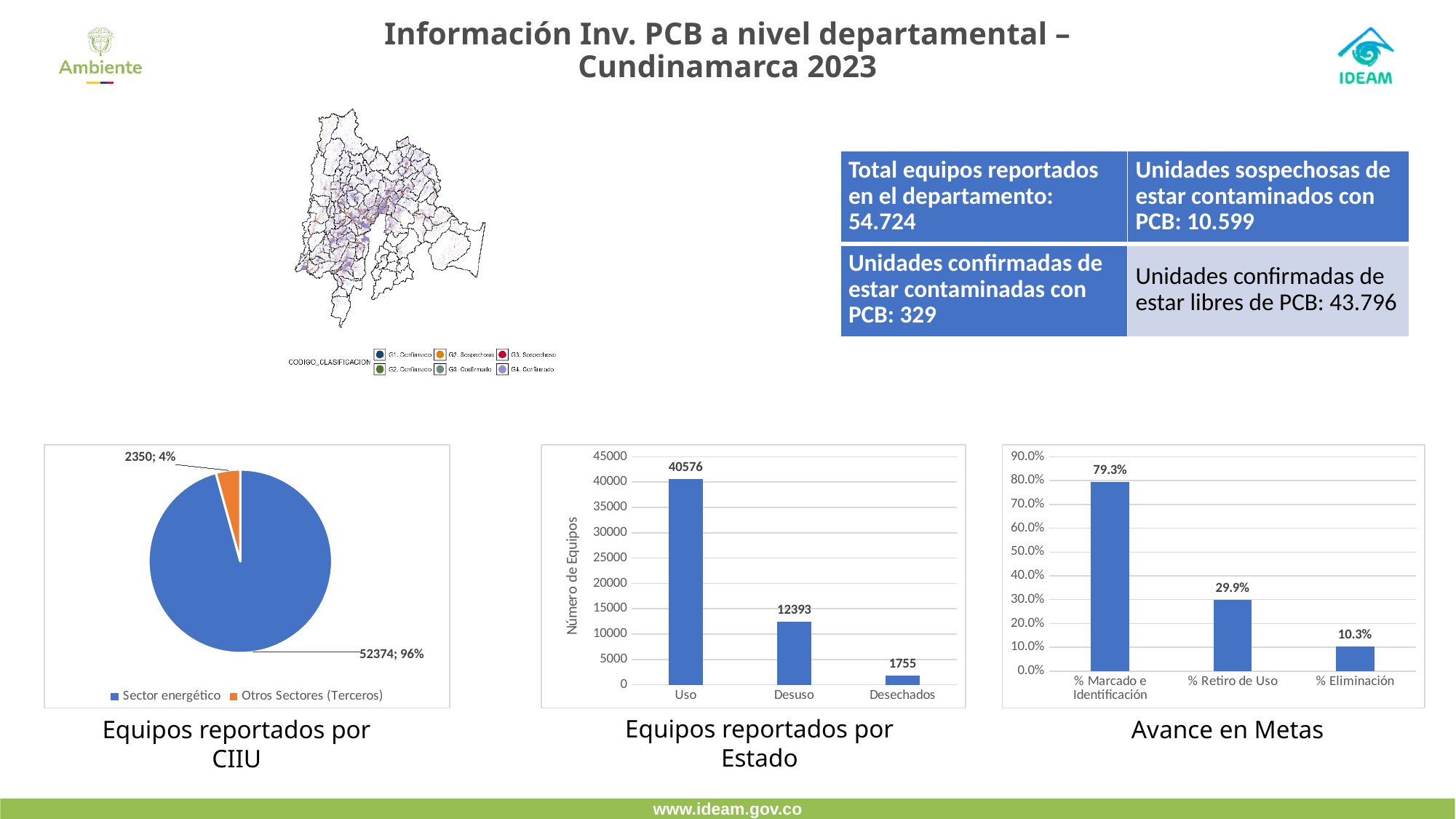
In the 'Equipos reportados por Estado' chart, which category has the highest value? Uso In the 'Avance en Metas' chart, what is the value for % Retiro de Uso? 29.9% In the 'Equipos reportados por Estado' chart, what is the value for Desuso? 12393 What type of chart is 'Equipos reportados por CIIU'? Pie chart In the 'Equipos reportados por CIIU' pie chart, how many slices are there? 2 In the 'Equipos reportados por Estado' chart, which category has the lowest value? Desechados In the 'Avance en Metas' chart, do the values rise or fall from left to right? Fall In the 'Equipos reportados por CIIU' pie chart, what value is shown for Sector energético? 52374; 96% In the 'Equipos reportados por CIIU' pie chart, what share of the pie does Otros Sectores (Terceros) have? 4% In the 'Equipos reportados por Estado' chart, what is the difference between Uso and Desuso? 28183 What type of chart is 'Equipos reportados por Estado'? Bar chart In the 'Avance en Metas' chart, what is the difference between % Marcado e Identificación and % Eliminación? 69.0%